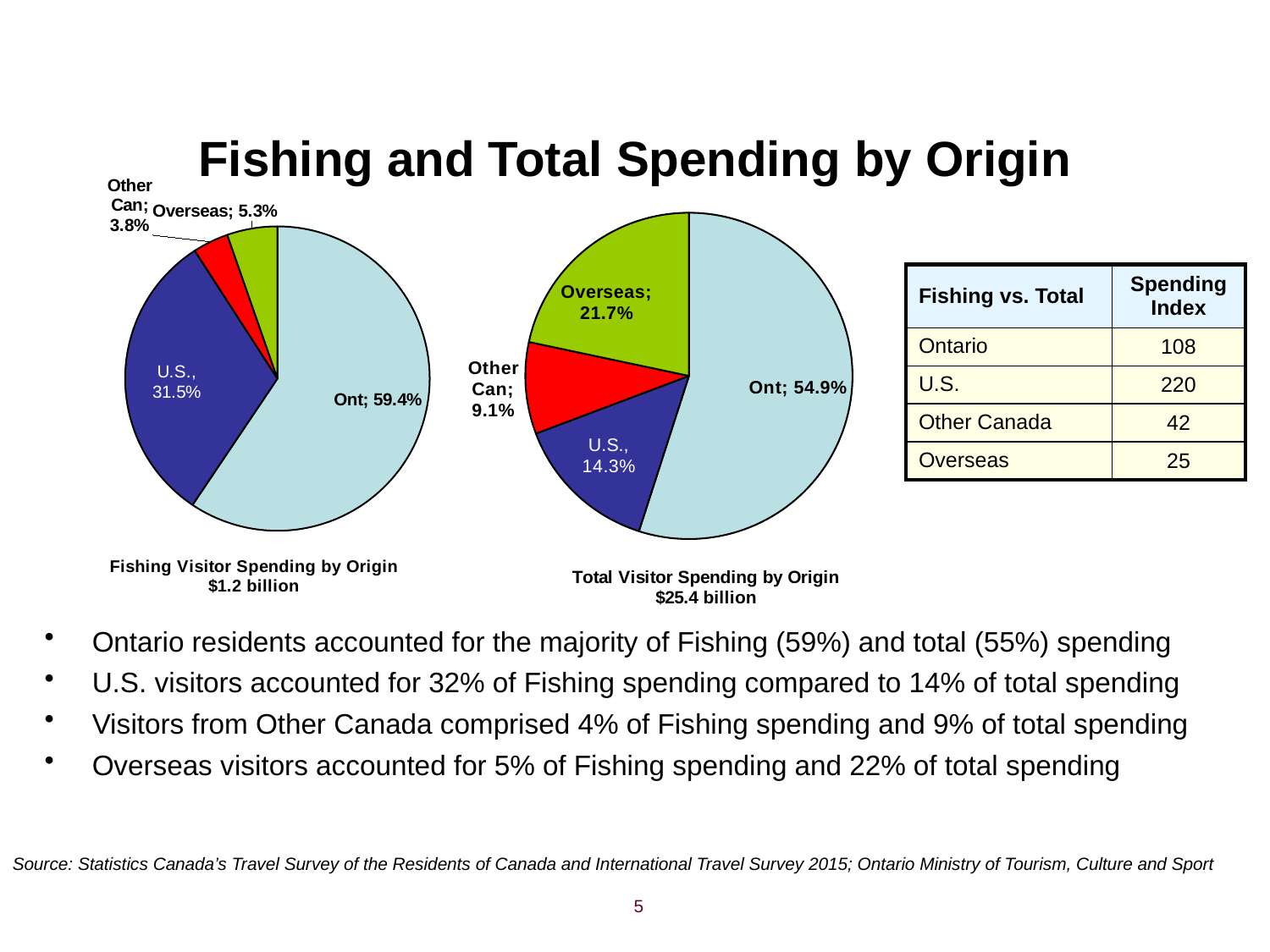
In the Total Visitor Spending by Origin pie chart, which origin has the largest share? Ont What total dollar amount is shown beneath the Fishing Visitor Spending by Origin pie chart? $1.2 billion In the Fishing Visitor Spending by Origin pie chart, what is the U.S. share? 31.5% In the Fishing Visitor Spending by Origin pie chart, what share of spending is attributed to Ontario? 59.4% In the Total Visitor Spending by Origin pie chart, which is larger: the U.S. share or the Overseas share? Overseas What type of chart is used to show Total Visitor Spending by Origin? Pie chart What is the difference between the Ontario share in the Fishing Visitor Spending pie chart and the Ontario share in the Total Visitor Spending pie chart? 4.5% How many slices does the Fishing Visitor Spending by Origin pie chart have? 4 In the Total Visitor Spending by Origin pie chart, what share of spending comes from Overseas visitors? 21.7% In the Total Visitor Spending by Origin pie chart, what is the share for Other Can? 9.1% In the Fishing Visitor Spending by Origin pie chart, which origin has the smallest share? Other Can In the Fishing Visitor Spending by Origin pie chart, what is the difference between the U.S. share and the Overseas share? 26.2%